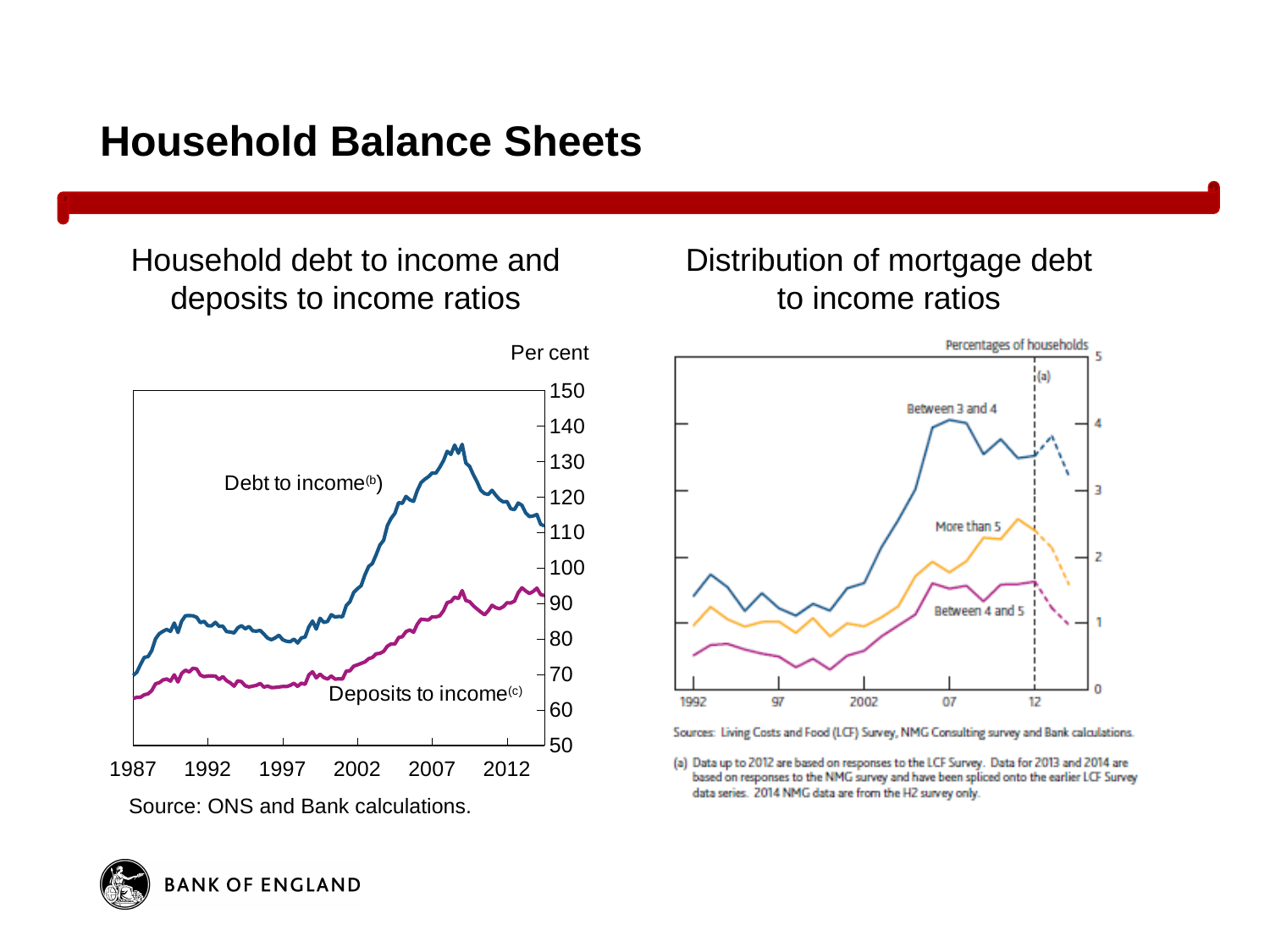
On the right chart, is the value of 'Between 4 and 5' in 1992 greater or less than 1? less On the left chart, is the value of Deposits to income in 1987 greater or less than 70? less On the left chart, which series is higher throughout the period, Debt to income or Deposits to income? Debt to income How many series are plotted on the left chart, 'Household debt to income and deposits to income ratios'? 2 How many series are plotted on the right chart, 'Distribution of mortgage debt to income ratios'? 3 What unit is shown on the y axis of the left chart? Per cent On the left chart, is the peak value of Debt to income around 2008 greater or less than 130? greater On the left chart, does Debt to income rise or fall between 2002 and 2007? rise What kind of chart is the left chart, 'Household debt to income and deposits to income ratios'? line chart On the right chart, which series reaches the highest value? Between 3 and 4